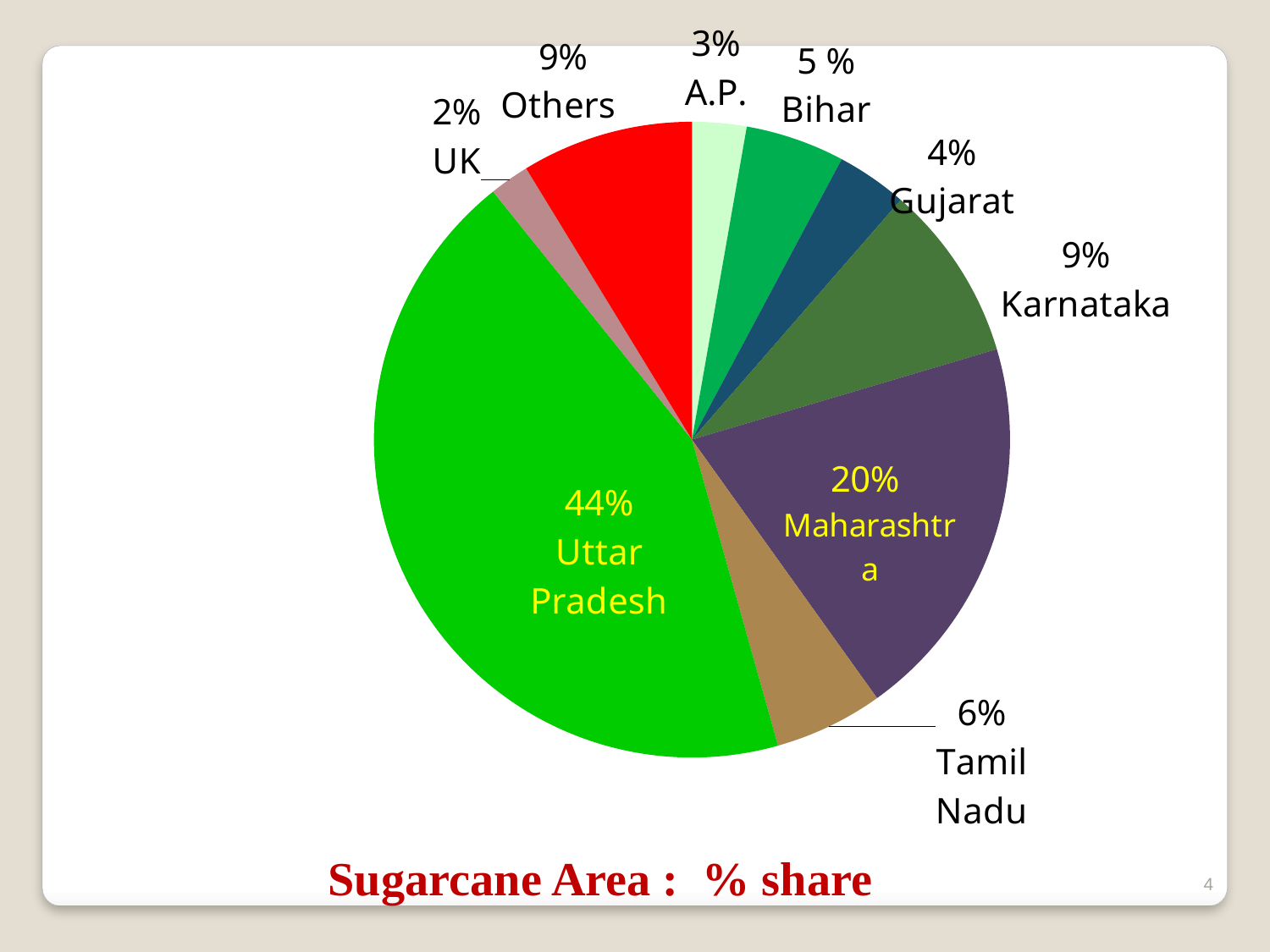
What is the share for Tamil Nadu? 6% Which state has the largest share of sugarcane area? Uttar Pradesh What is the share for Karnataka? 9% What is the share for Gujarat? 4% What is the share for Uttar Pradesh? 44% What is the difference in share between Uttar Pradesh and Maharashtra? 24% How many slices does the pie chart have? 9 What kind of chart is shown on the slide? pie chart Which slice has the smallest share? UK What is the share for UK? 2% Which has a larger share, Bihar or Gujarat? Bihar What is the share for Maharashtra? 20%